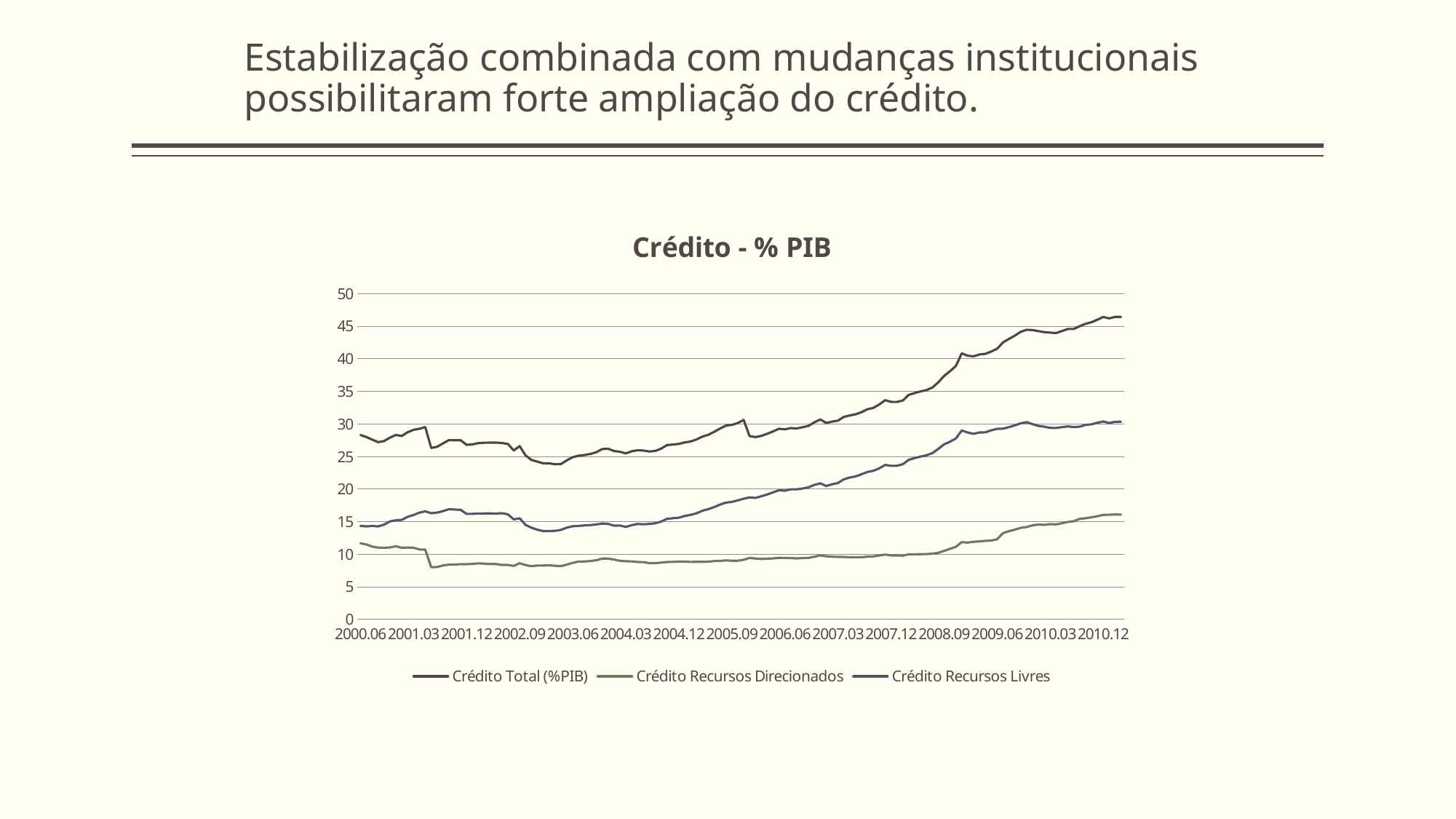
How many series does the legend of the chart list? 3 What kind of chart is shown on the slide? Line chart Is the value of Crédito Recursos Direcionados at 2003.06 greater or less than 10? less At 2010.12, which is larger: Crédito Recursos Livres or Crédito Recursos Direcionados? Crédito Recursos Livres Is the value of Crédito Recursos Livres at 2000.06 greater or less than 20? less What is the title of the chart? Crédito - % PIB Is the value of Crédito Total (%PIB) at 2010.12 greater or less than 45? greater Does Crédito Total (%PIB) overall rise or fall from 2000.06 to 2010.12? Rise Which series is plotted with the green line? Crédito Recursos Direcionados Which series has the lowest values across the whole period? Crédito Recursos Direcionados